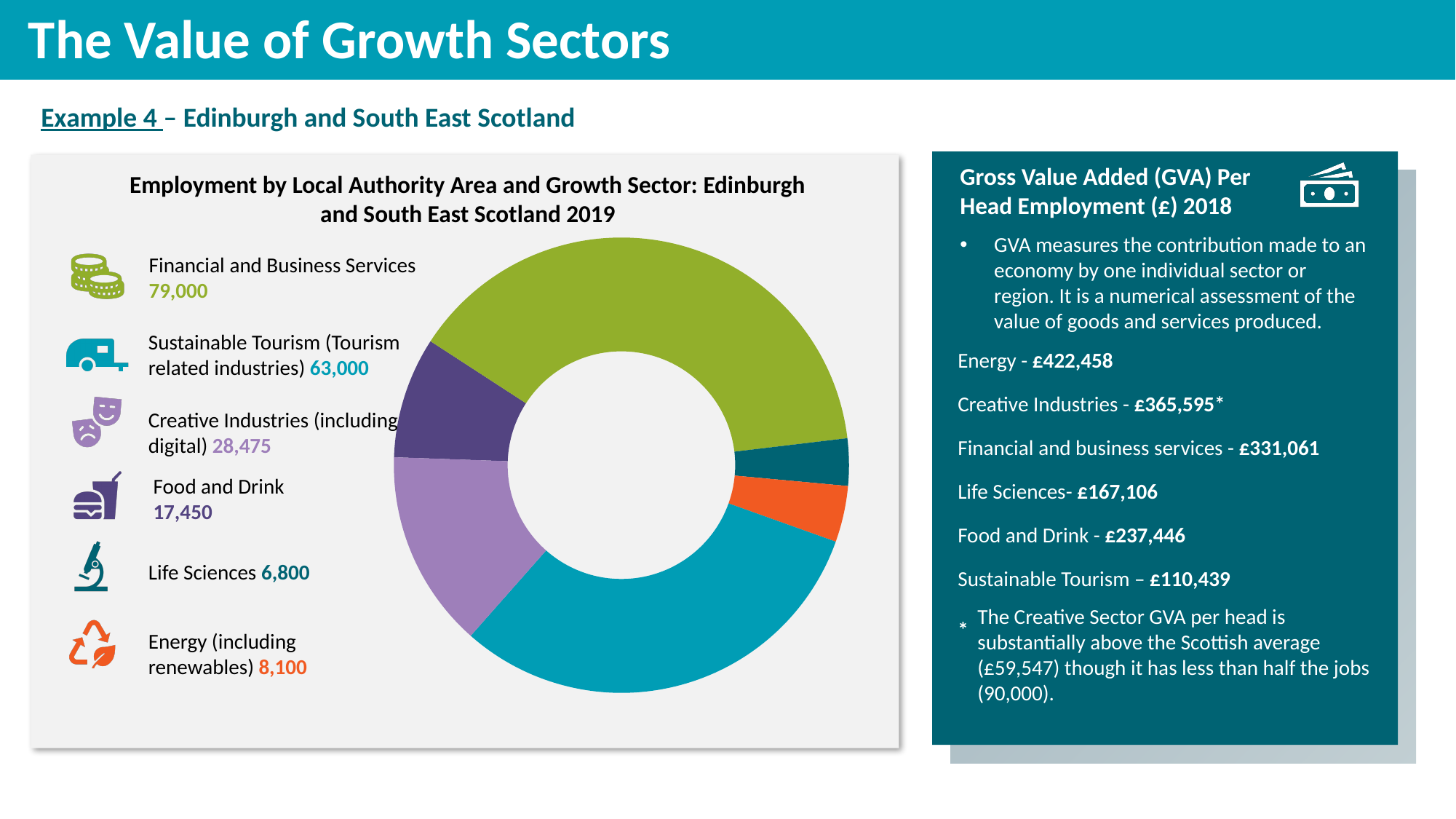
What is the title of the chart? Employment by Local Authority Area and Growth Sector: Edinburgh and South East Scotland 2019 What is the employment figure for Life Sciences? 6,800 What is the employment figure for Financial and Business Services? 79,000 Which sector has the lowest employment in the chart? Life Sciences What kind of chart is shown on the slide? doughnut chart What is the difference in employment between Energy (including renewables) and Life Sciences? 1,300 What is the difference in employment between Financial and Business Services and Sustainable Tourism? 16,000 Which has higher employment, Creative Industries (including digital) or Food and Drink? Creative Industries (including digital) Which sector has the highest employment in the chart? Financial and Business Services What is the employment figure for Creative Industries (including digital)? 28,475 What is the employment figure for Sustainable Tourism (Tourism related industries)? 63,000 How many sectors are shown in the chart? 6